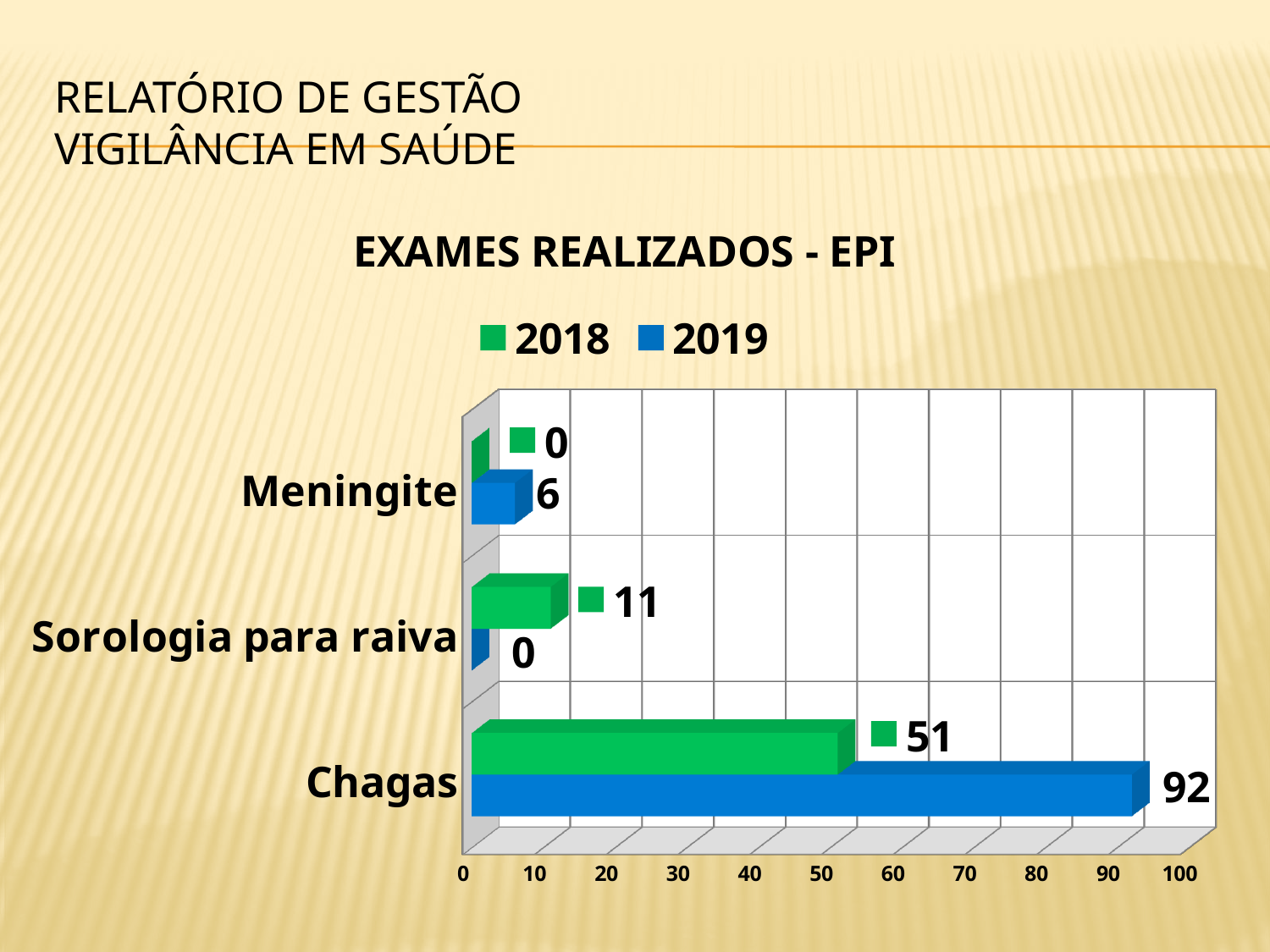
What is the value for Meningite in 2018? 0 Which category has the lowest value in 2018? Meningite Which is larger for Sorologia para raiva, the 2018 value or the 2019 value? 2018 What is the value for Sorologia para raiva in 2018? 11 What is the value for Meningite in 2019? 6 Which category has the highest value in 2019? Chagas What is the value for Chagas in 2019? 92 What is the value for Chagas in 2018? 51 How many categories are shown on the chart? 3 What is the title of the chart? EXAMES REALIZADOS - EPI What is the difference between the 2019 and 2018 values for Chagas? 41 How many series does the legend list? 2